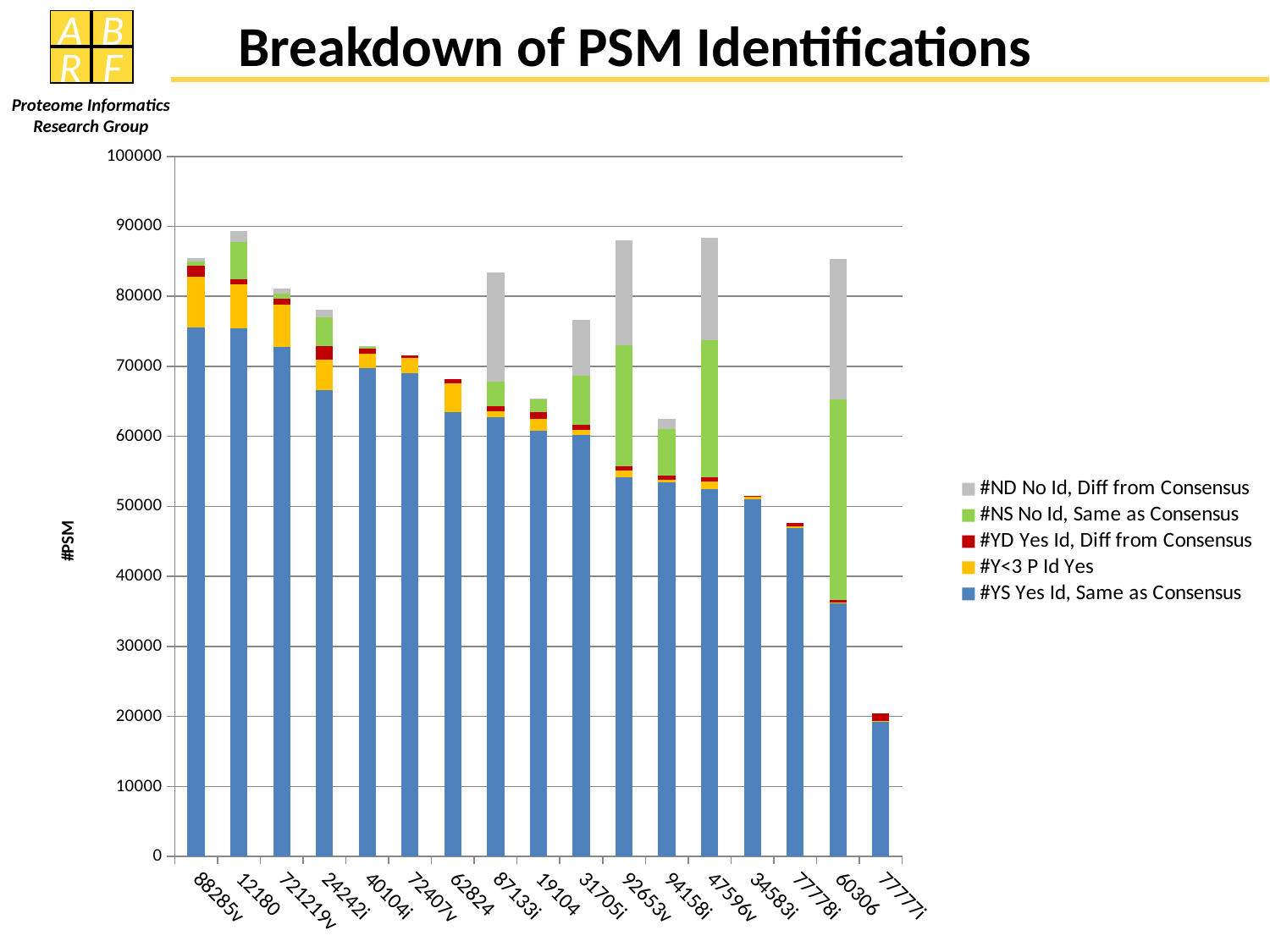
What kind of chart is shown on the slide? Stacked bar chart Does the #YS Yes Id, Same as Consensus series generally rise or fall from left to right along the x axis? fall What is the label on the vertical axis of the chart? #PSM How many categories (sample IDs) are shown along the x axis? 17 Which has the larger #YS Yes Id, Same as Consensus value, 88285v or 60306? 88285v Which category has the lowest total bar height? 77777i Is the #YS Yes Id, Same as Consensus value for 88285v greater or less than 70000? greater Is the #YS Yes Id, Same as Consensus value for 60306 greater or less than 40000? less How many series does the legend list? 5 Which category has the lowest value for the #YS Yes Id, Same as Consensus series? 77777i Is the total bar height for 12180 greater or less than 80000? greater